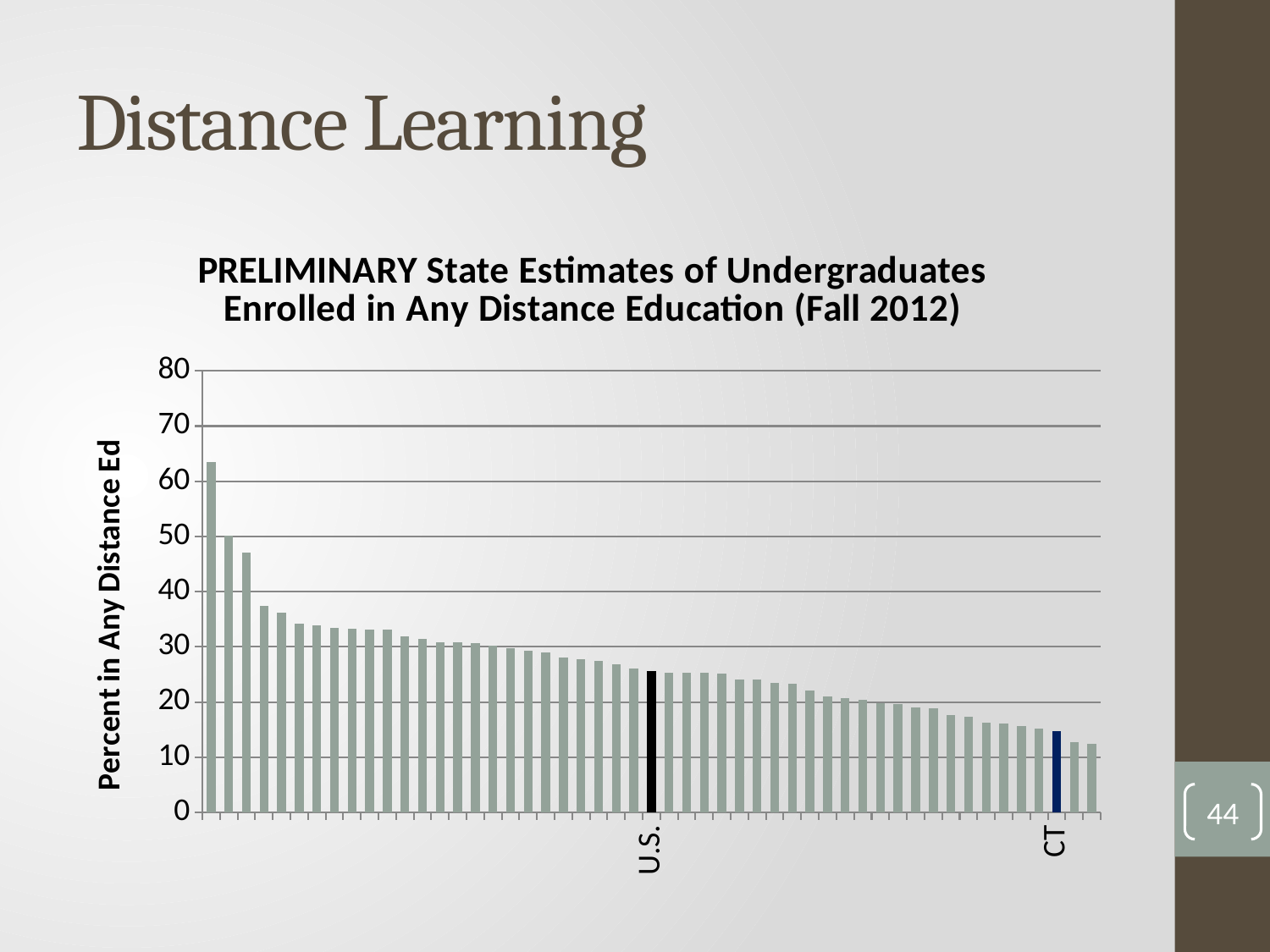
Is the value for U.S. greater or less than 30? less Is the tallest bar in the chart greater or less than 60? greater Which has the higher percent in any distance ed, U.S. or CT? U.S. Is the value for CT greater or less than 20? less What kind of chart is shown on the slide? bar chart What is the label on the vertical axis of the chart? Percent in Any Distance Ed What colour is the bar for CT? dark blue Do the bar values rise or fall from left to right across the chart? fall